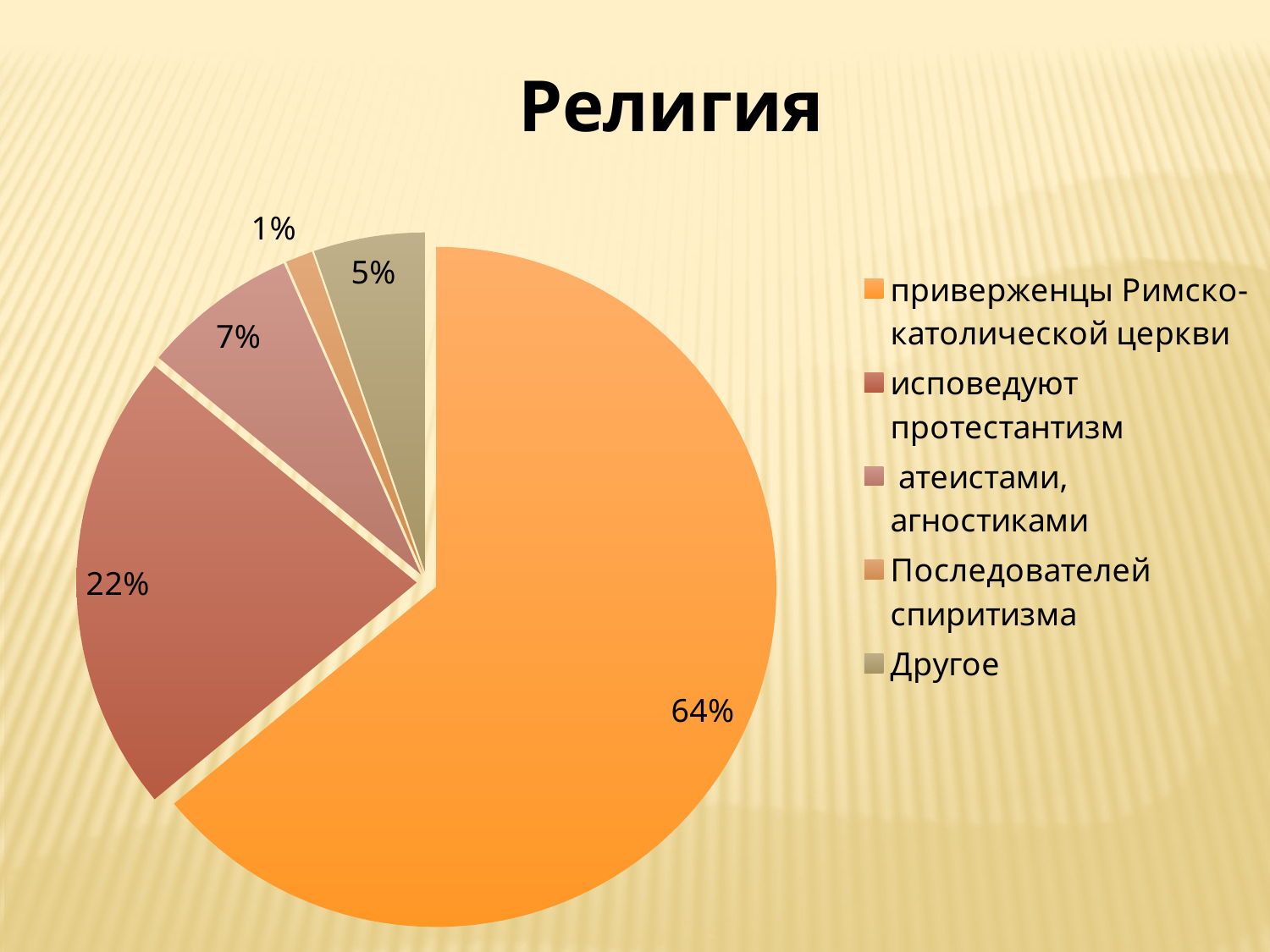
How many slices does the pie chart have? 5 Which category has the largest slice of the pie? приверженцы Римско-католической церкви What is the difference between the share for 'приверженцы Римско-католической церкви' and the share for 'исповедуют протестантизм'? 42% What share of the pie is labelled 'приверженцы Римско-католической церкви'? 64% What share of the pie is labelled 'исповедуют протестантизм'? 22% How many entries does the legend list? 5 What share of the pie is labelled 'Другое'? 5% What is the title of the chart? Религия Which category has the smallest slice of the pie? Последователей спиритизма What kind of chart is shown on the slide? pie chart